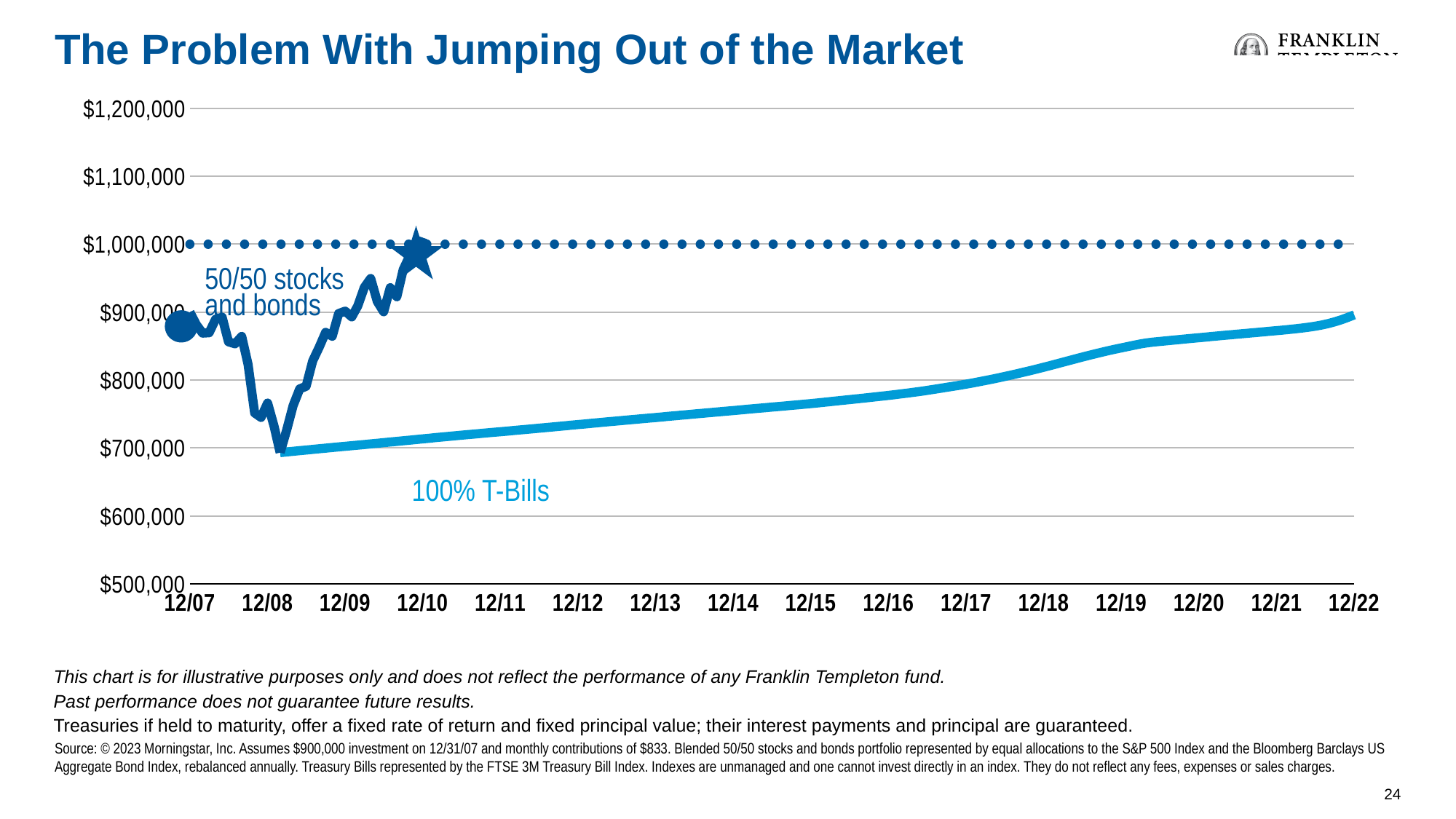
What is the highest value shown on the y axis? $1,200,000 At what value does the dotted line run from 12/10 to 12/22? $1,000,000 Is the value of the 100% T-Bills line at 12/14 greater or less than $800,000? less What is the title of the slide? The Problem With Jumping Out of the Market Does the 100% T-Bills line rise or fall from 12/09 to 12/22? rise At 12/10, which series has the higher value, 50/50 stocks and bonds or 100% T-Bills? 50/50 stocks and bonds What are the names of the two series labelled on the chart? 50/50 stocks and bonds; 100% T-Bills Is the value of the 100% T-Bills line at 12/19 greater or less than $800,000? greater How many series are labelled on the chart? 2 Is the value of the 50/50 stocks and bonds line at 12/08 greater or less than $800,000? less How many date labels are shown on the x axis? 16 What kind of chart is shown on the slide? line chart